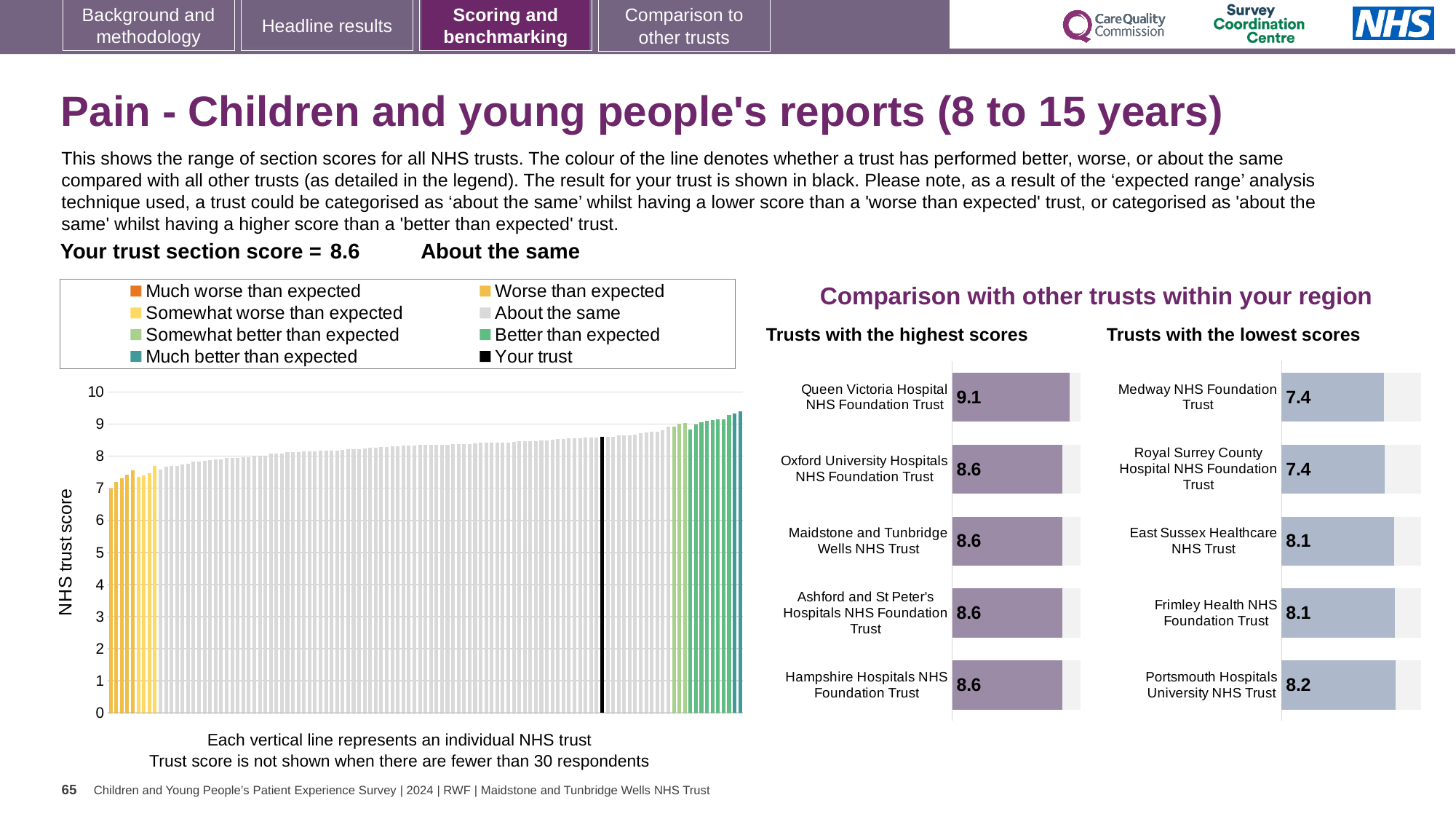
In the large chart on the left, how many entries does the legend list? 8 In the 'Trusts with the highest scores' chart, what is the score for Queen Victoria Hospital NHS Foundation Trust? 9.1 In the large chart on the left, is the value of the black bar (Your trust) greater or less than 8? greater In the 'Trusts with the highest scores' chart, what is the difference between the scores of Queen Victoria Hospital NHS Foundation Trust and Hampshire Hospitals NHS Foundation Trust? 0.5 In the large chart on the left, what colour represents 'Your trust' in the legend? black In the 'Trusts with the lowest scores' chart, which has the larger score: East Sussex Healthcare NHS Trust or Royal Surrey County Hospital NHS Foundation Trust? East Sussex Healthcare NHS Trust What kind of chart is the large chart on the left showing NHS trust scores? bar chart In the 'Trusts with the highest scores' chart, which trust has the highest score? Queen Victoria Hospital NHS Foundation Trust In the 'Trusts with the lowest scores' chart, what is the score for Medway NHS Foundation Trust? 7.4 In the large chart on the left, do the trust scores rise or fall from left to right? rise In the 'Trusts with the lowest scores' chart, which trust has the highest score? Portsmouth Hospitals University NHS Trust In the 'Trusts with the highest scores' chart, how many trusts are listed? 5